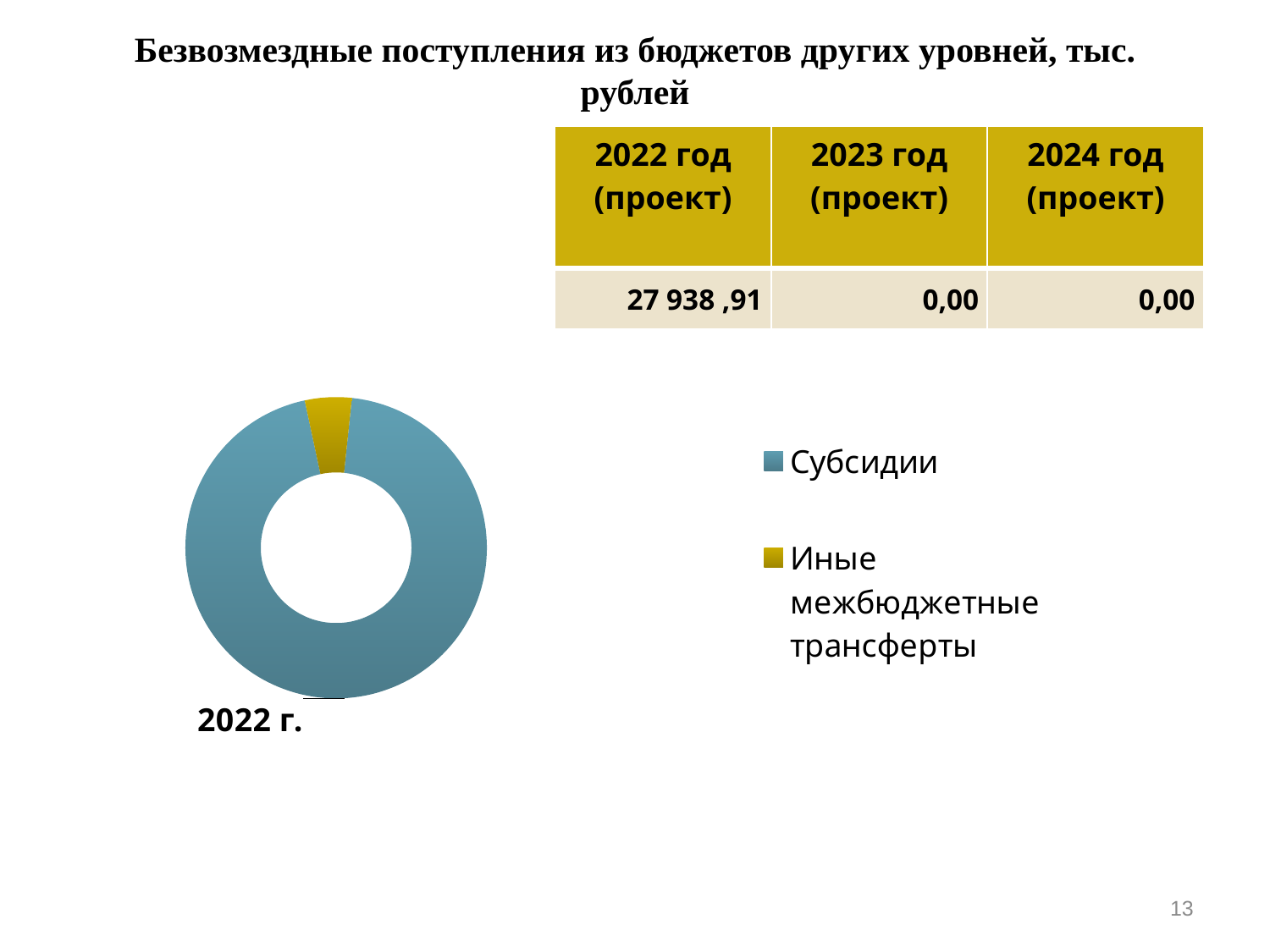
What year label is shown beneath the doughnut chart? 2022 г. Which category takes the smallest share of the doughnut chart? Иные межбюджетные трансферты What kind of chart is shown on the slide? Doughnut (pie) chart Which slice is larger: Субсидии or Иные межбюджетные трансферты? Субсидии What colour is the Субсидии slice in the doughnut chart? Teal (blue-green) Which category takes the largest share of the doughnut chart? Субсидии How many slices does the doughnut chart have? 2 Is the share of Субсидии in the doughnut chart greater or less than half? greater How many entries does the legend of the chart list? 2